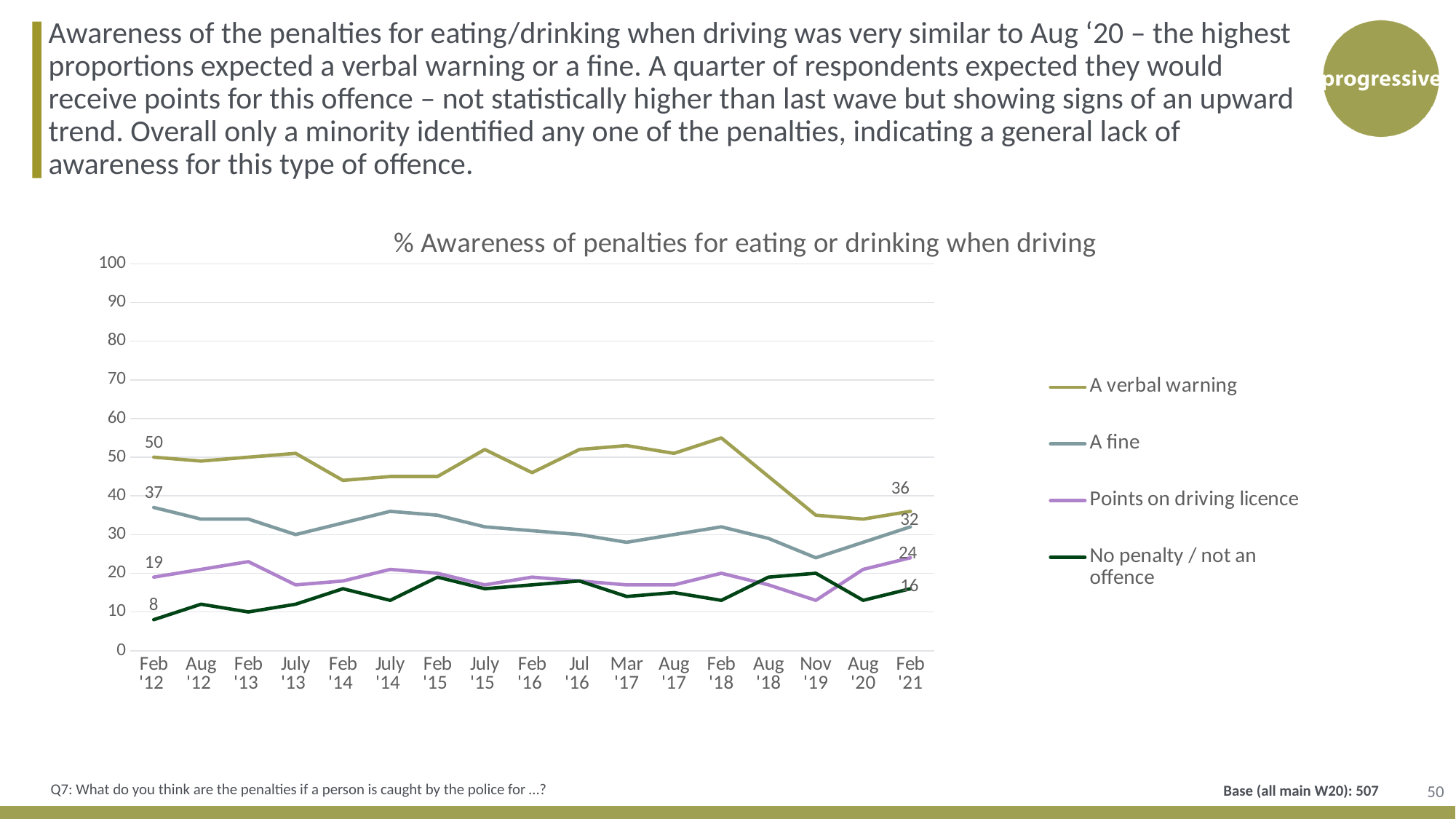
What is the value for 'No penalty / not an offence' in Feb '12? 8 What kind of chart is shown on the slide? line chart What is the difference between the 'A verbal warning' values in Feb '12 and Feb '21? 14 What is the value for 'A verbal warning' in Feb '12? 50 Which series has the highest value in Feb '21? A verbal warning Is the value for 'A verbal warning' in Feb '18 greater or less than 50? greater How many series does the legend list? 4 What is the title of the chart? % Awareness of penalties for eating or drinking when driving Which series has the lowest value in Feb '12? No penalty / not an offence What is the value for 'Points on driving licence' in Feb '21? 24 What is the value for 'A fine' in Feb '21? 32 How many time points are shown along the x axis? 17